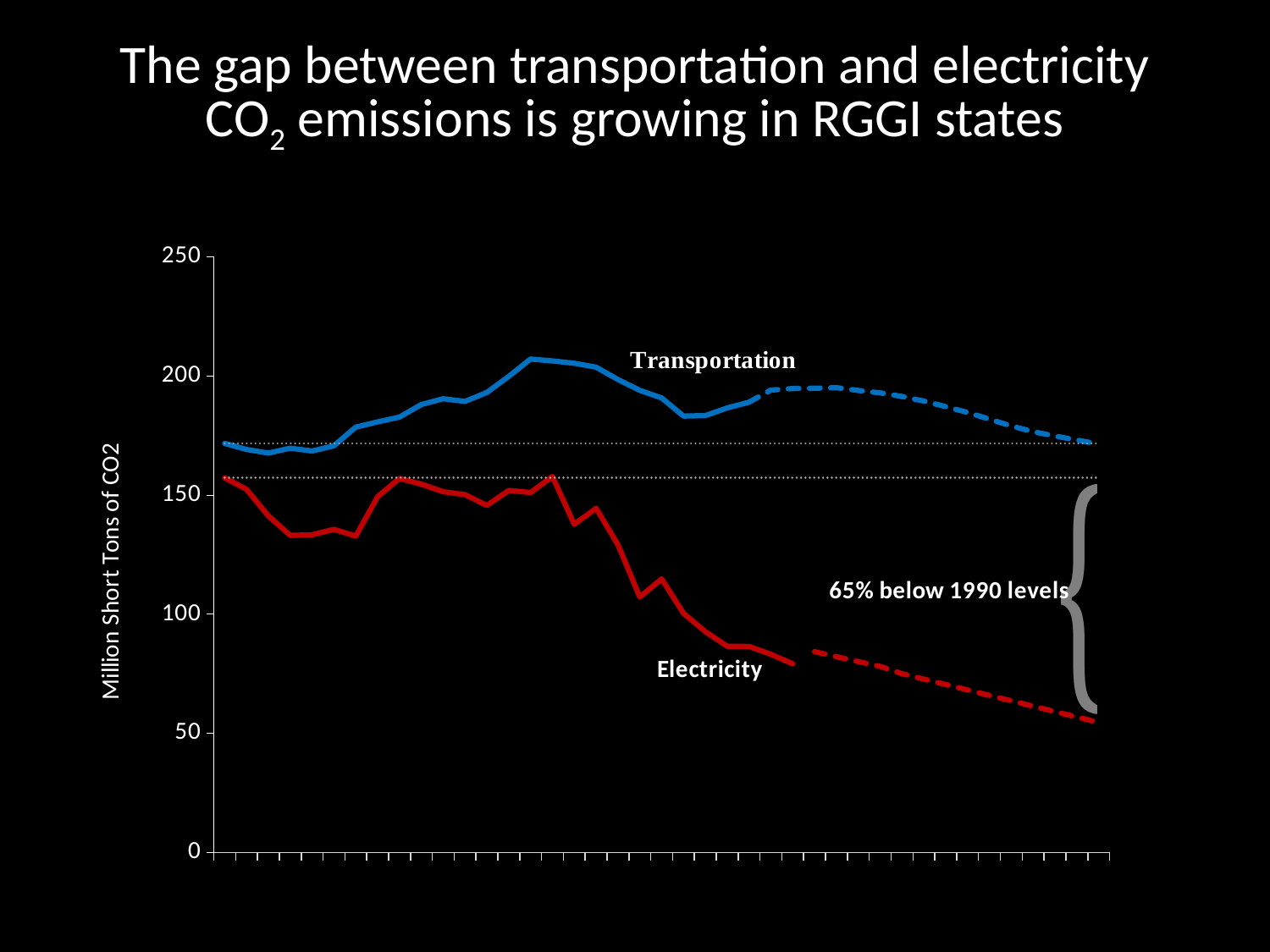
Is the peak value of the Transportation line greater or less than 200? greater How many data series are plotted on the chart? 2 Is the value of the Electricity line at the left end of the chart greater or less than 150? greater Does the Electricity line overall rise or fall from left to right? fall Which series has the lowest value shown on the chart? Electricity Is the value of the Electricity line at the right end of the chart greater or less than 100? less What kind of chart is shown on the slide? line chart What does the annotation next to the bracket on the right side of the chart say? 65% below 1990 levels Which series is plotted higher on the chart across its whole length, Transportation or Electricity? Transportation What is the label on the vertical axis? Million Short Tons of CO2